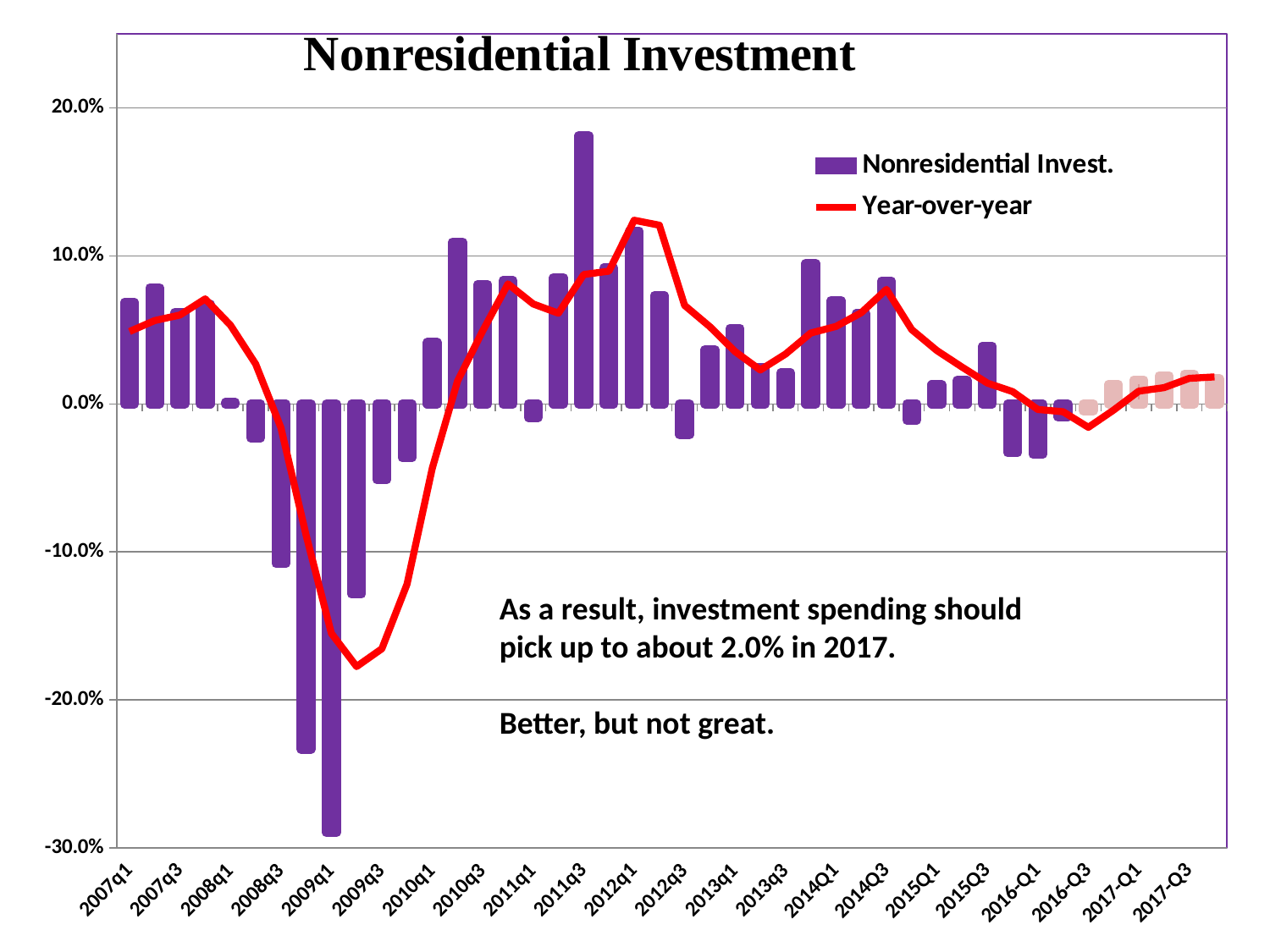
Do the Nonresidential Invest. bars rise or fall from 2008q1 to 2009q1? fall Which is larger, the Nonresidential Invest. bar for 2007q1 or for 2009q1? 2007q1 What are the two series named in the legend? Nonresidential Invest. and Year-over-year What kind of chart is shown on the slide? A bar chart with a line series How many series does the legend list? 2 Which quarter has the highest Nonresidential Invest. bar? 2011q3 Is the Nonresidential Invest. bar for 2009q1 greater or less than -20.0%? less Which quarter has the lowest Nonresidential Invest. bar? 2009q1 Is the Year-over-year value at 2009q3 greater or less than -10.0%? less Is the Nonresidential Invest. bar for 2011q3 greater or less than 10.0%? greater How many quarter labels are shown on the x axis? 22 What is the title of the chart? Nonresidential Investment